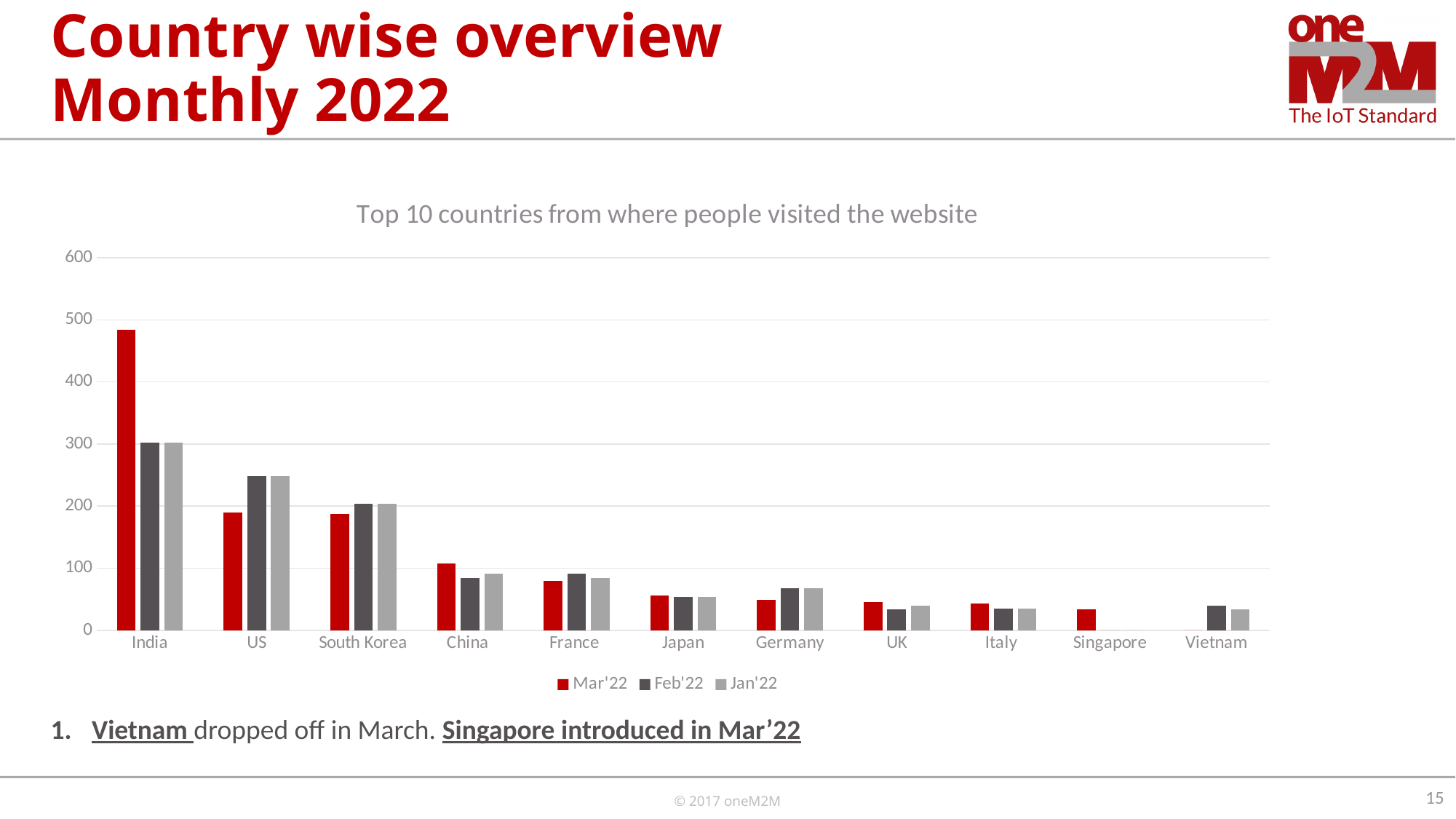
What kind of chart is shown on the slide? bar chart Which is larger: the Mar'22 value for India or the Mar'22 value for South Korea? India How many countries are shown on the x axis of the chart? 11 How many series does the legend list? 3 For the US, which is larger: the Mar'22 value or the Feb'22 value? Feb'22 Is the Mar'22 value for India greater or less than 400? greater Is the Feb'22 value for US greater or less than 200? greater Which country has the highest Mar'22 value? India Is the Jan'22 value for Germany greater or less than 100? less Which country has no Mar'22 bar in the chart? Vietnam What is the title of the chart? Top 10 countries from where people visited the website